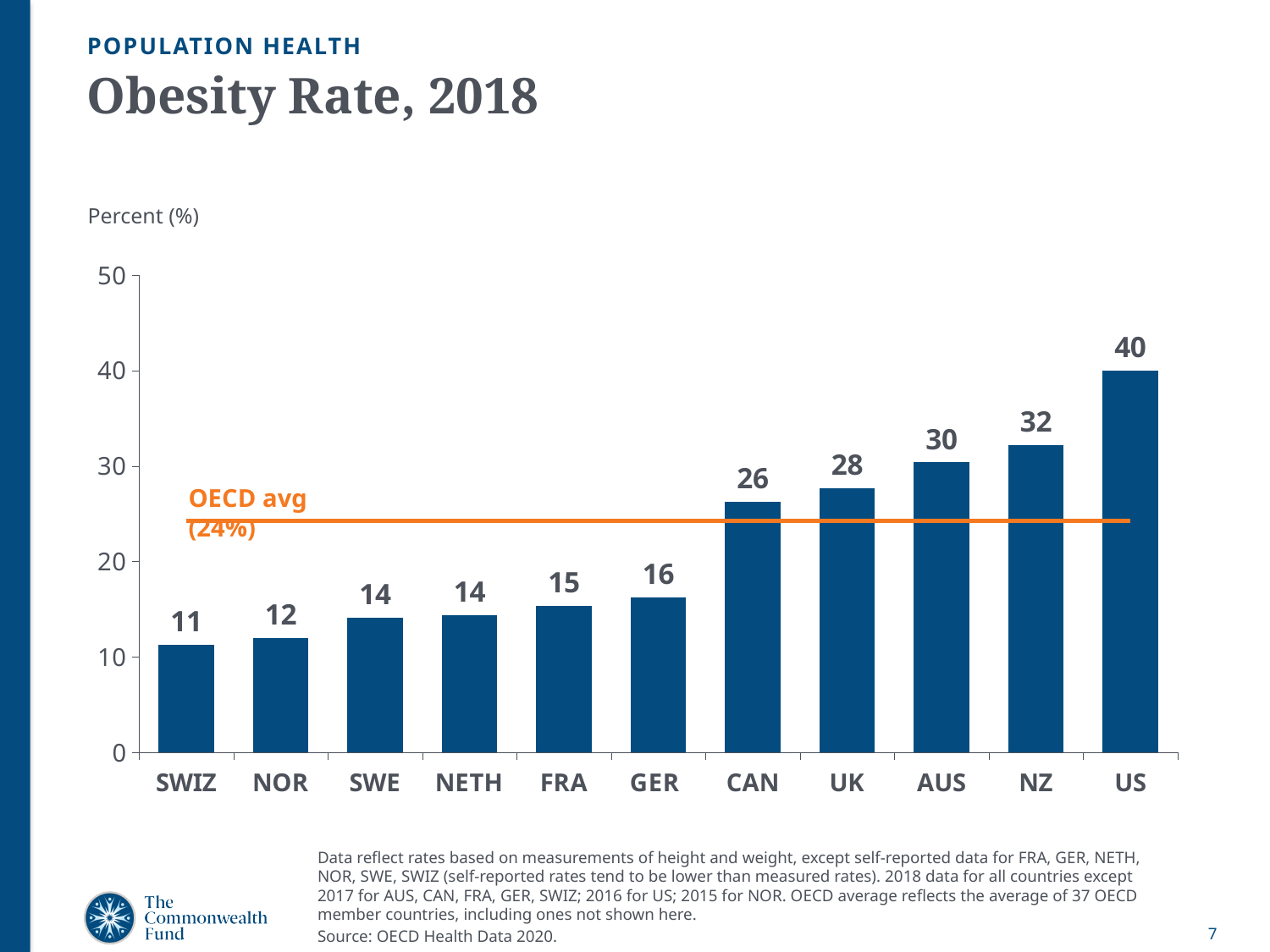
Which has a higher obesity rate, UK or GER? UK Which country has the highest obesity rate on the chart? US What is the difference between the obesity rates of the US and SWIZ? 29 What is the obesity rate shown for the US? 40 Which country has the lowest obesity rate on the chart? SWIZ Is the obesity rate for FRA greater or less than 20? less What kind of chart is shown on the slide? bar chart How many countries are shown on the chart? 11 What is the obesity rate shown for CAN? 26 What is the difference between the obesity rates of NZ and AUS? 2 Do the obesity rates rise or fall from left to right across the chart? rise What value does the orange OECD average line represent? 24%